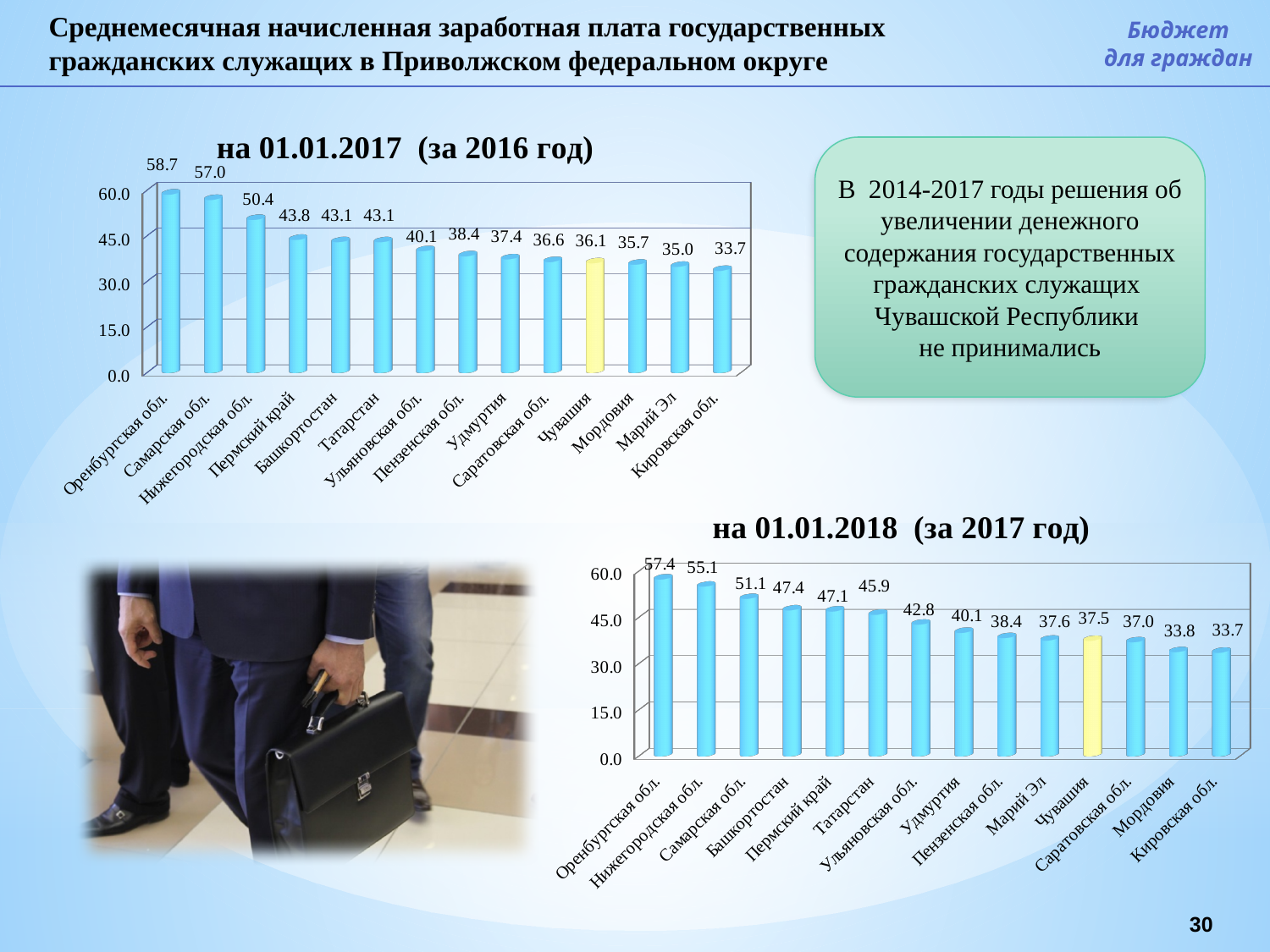
In the chart titled "на 01.01.2017 (за 2016 год)", how many regions are shown? 14 In the chart titled "на 01.01.2018 (за 2017 год)", do the values rise or fall from left to right along the x axis? fall In the chart titled "на 01.01.2018 (за 2017 год)", what is the value for Чувашия? 37.5 In the chart titled "на 01.01.2018 (за 2017 год)", what is the difference between the values for Оренбургская обл. and Кировская обл.? 23.7 In the chart titled "на 01.01.2017 (за 2016 год)", what is the value for Чувашия? 36.1 In the chart titled "на 01.01.2018 (за 2017 год)", which region has the highest value? Оренбургская обл. In the chart titled "на 01.01.2018 (за 2017 год)", which is larger, the value for Нижегородская обл. or Самарская обл.? Нижегородская обл. What kind of chart is the chart titled "на 01.01.2017 (за 2016 год)"? bar chart In the chart titled "на 01.01.2017 (за 2016 год)", which region has the highest value? Оренбургская обл. In the chart titled "на 01.01.2017 (за 2016 год)", what is the difference between the values for Оренбургская обл. and Самарская обл.? 1.7 In the chart titled "на 01.01.2018 (за 2017 год)", what is the value for Татарстан? 45.9 In the chart titled "на 01.01.2017 (за 2016 год)", which region has the lowest value? Кировская обл.